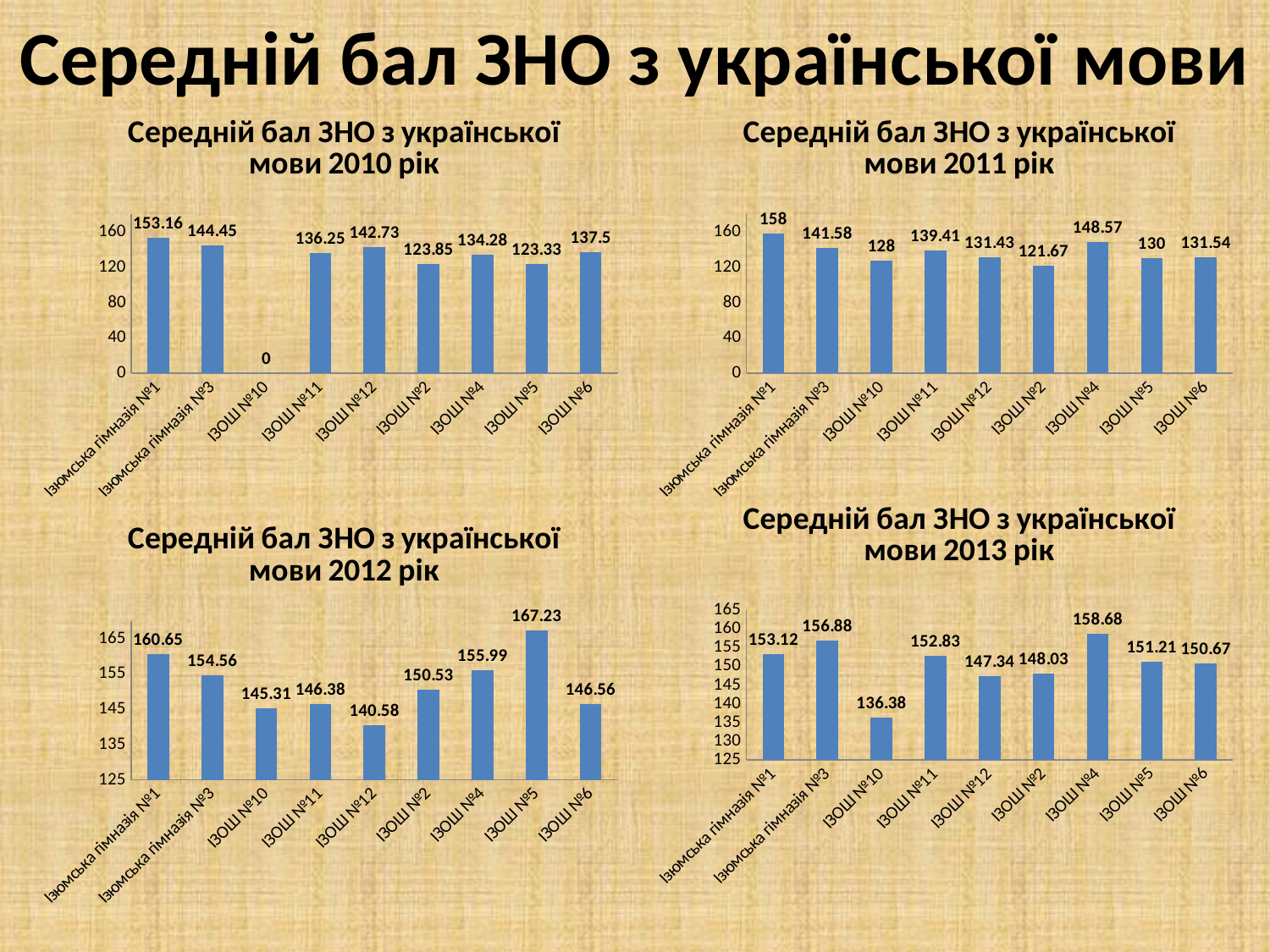
In the chart titled "Середній бал ЗНО з української мови 2011 рік", what is the value for ІЗОШ №4? 148.57 How many categories are shown in the chart titled "Середній бал ЗНО з української мови 2013 рік"? 9 In the chart titled "Середній бал ЗНО з української мови 2011 рік", which category has the lowest value? ІЗОШ №2 In the chart titled "Середній бал ЗНО з української мови 2011 рік", what is the difference between the values for Ізюмська гімназія №1 and ІЗОШ №5? 28 In the chart titled "Середній бал ЗНО з української мови 2012 рік", which is larger: the value for Ізюмська гімназія №1 or the value for ІЗОШ №4? Ізюмська гімназія №1 In the chart titled "Середній бал ЗНО з української мови 2013 рік", what is the difference between the values for ІЗОШ №4 and ІЗОШ №10? 22.3 In the chart titled "Середній бал ЗНО з української мови 2012 рік", which category has the highest value? ІЗОШ №5 What kind of chart is the chart titled "Середній бал ЗНО з української мови 2011 рік"? bar chart In the chart titled "Середній бал ЗНО з української мови 2010 рік", what is the value for Ізюмська гімназія №1? 153.16 How many charts are shown on the slide? 4 In the chart titled "Середній бал ЗНО з української мови 2010 рік", what is the value for ІЗОШ №10? 0 In the chart titled "Середній бал ЗНО з української мови 2013 рік", which category has the lowest value? ІЗОШ №10